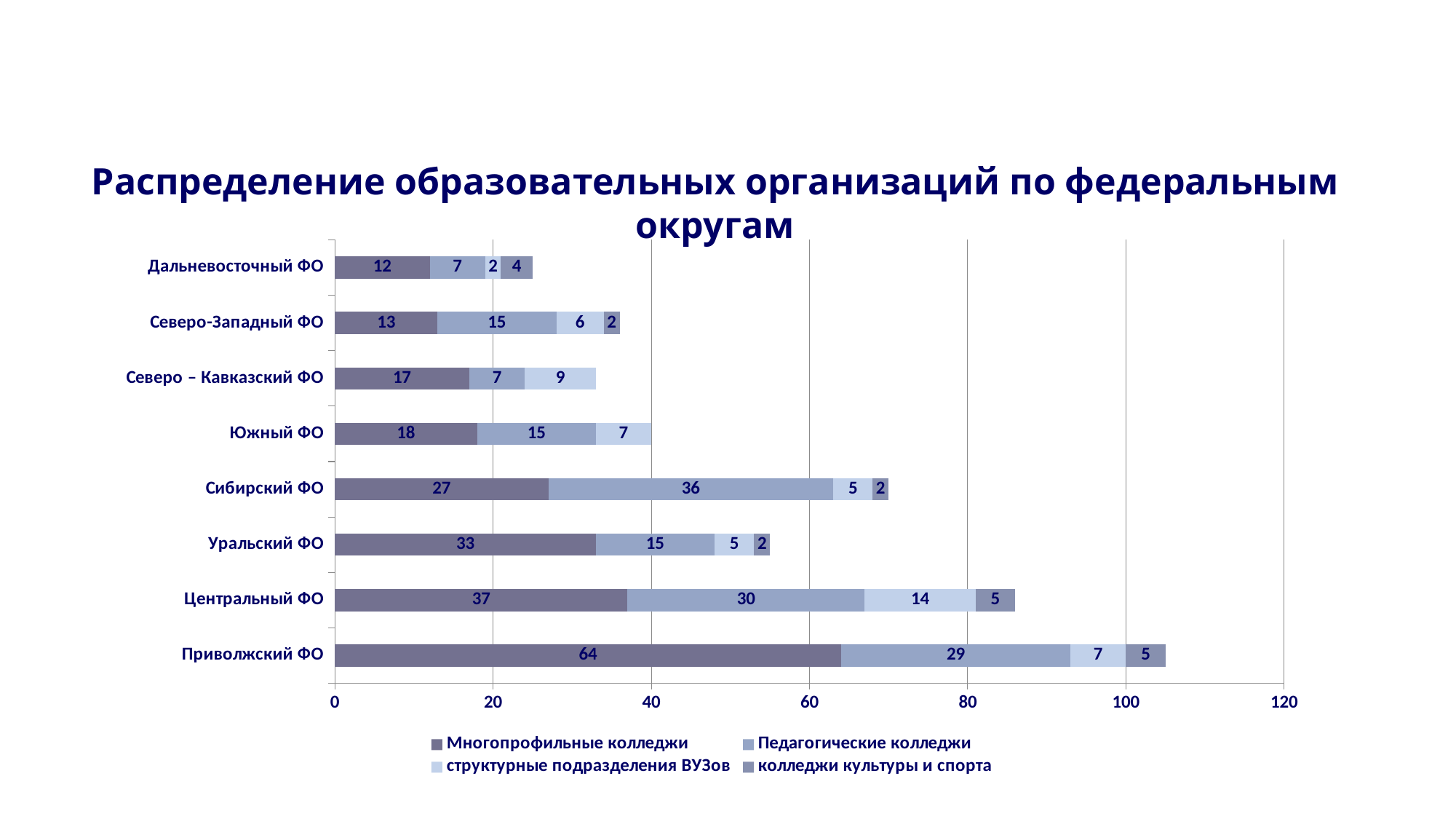
What is the difference between the Многопрофильные колледжи values for Приволжский ФО and Центральный ФО? 27 What is the total of the stacked bar for Приволжский ФО? 105 Which federal district has the highest value for Многопрофильные колледжи? Приволжский ФО What kind of chart is shown on the slide? Stacked bar chart What is the value of Многопрофильные колледжи for Приволжский ФО? 64 How many federal districts (categories) are shown on the chart? 8 What is the value of Педагогические колледжи for Сибирский ФО? 36 Which federal district has the lowest value for Многопрофильные колледжи? Дальневосточный ФО What is the value of структурные подразделения ВУЗов for Центральный ФО? 14 What is the total of the stacked bar for Сибирский ФО? 70 Which is larger: Педагогические колледжи for Центральный ФО or for Приволжский ФО? Центральный ФО How many series does the legend list? 4